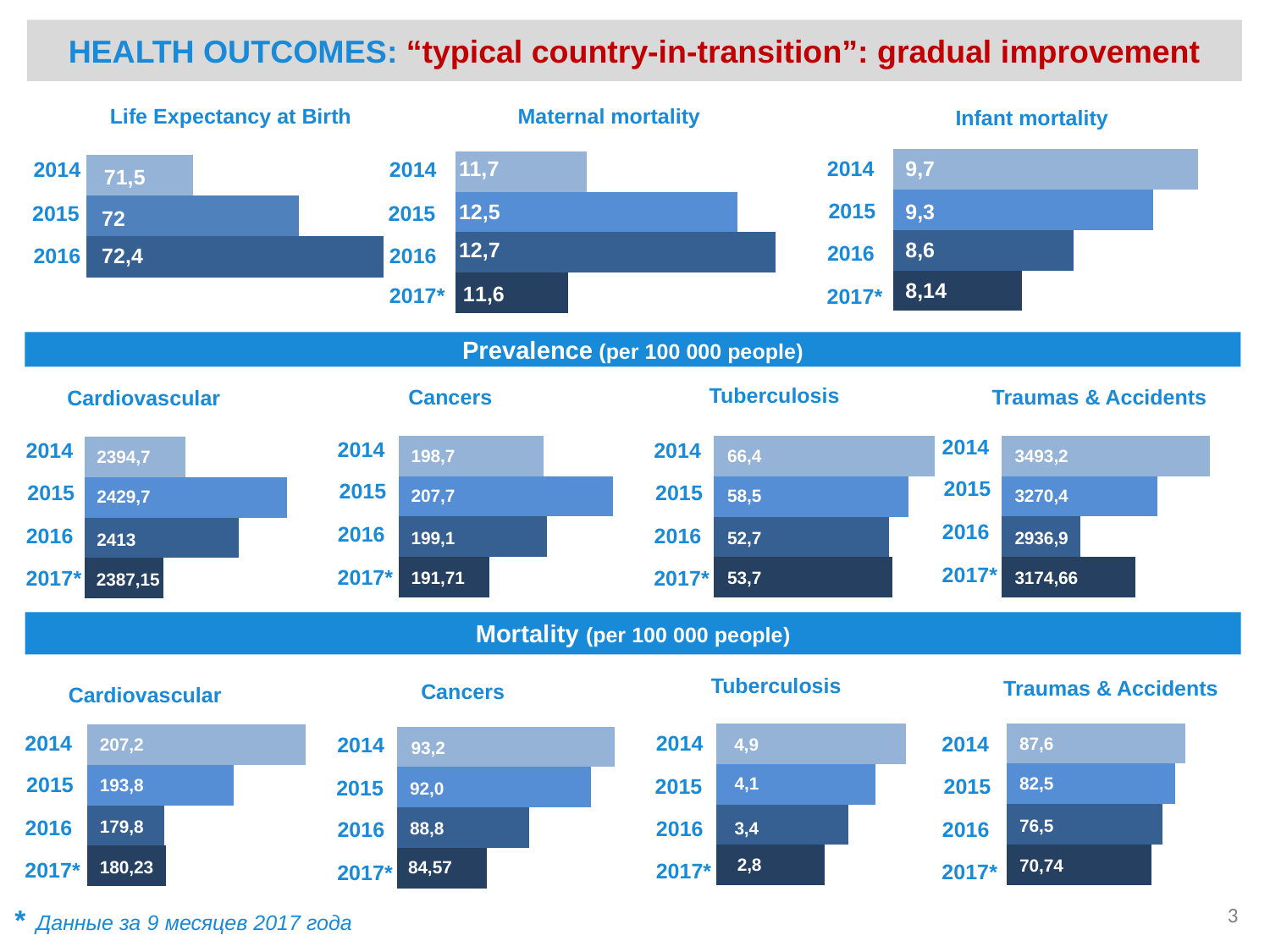
In the Prevalence Traumas & Accidents chart, which year has the lowest value? 2016 In the Prevalence Cancers chart, what is the value for 2017*? 191,71 In the Infant mortality chart, what is the difference between the 2014 and 2017* values? 1,56 In the Prevalence Tuberculosis chart, which is larger, the value for 2016 or 2017*? 2017* In the Maternal mortality chart, which year has the highest value? 2016 How many years are shown in the Mortality Traumas & Accidents chart? 4 In the Life Expectancy at Birth chart, what is the value for 2016? 72,4 What kind of chart is the Mortality Cardiovascular chart? bar chart In the Mortality Tuberculosis chart, what is the difference between the 2014 and 2017* values? 2,1 In the Mortality Tuberculosis chart, do the values rise or fall from 2014 to 2017*? fall In the Prevalence Cardiovascular chart, which year has the highest value? 2015 In the Infant mortality chart, what is the value for 2017*? 8,14